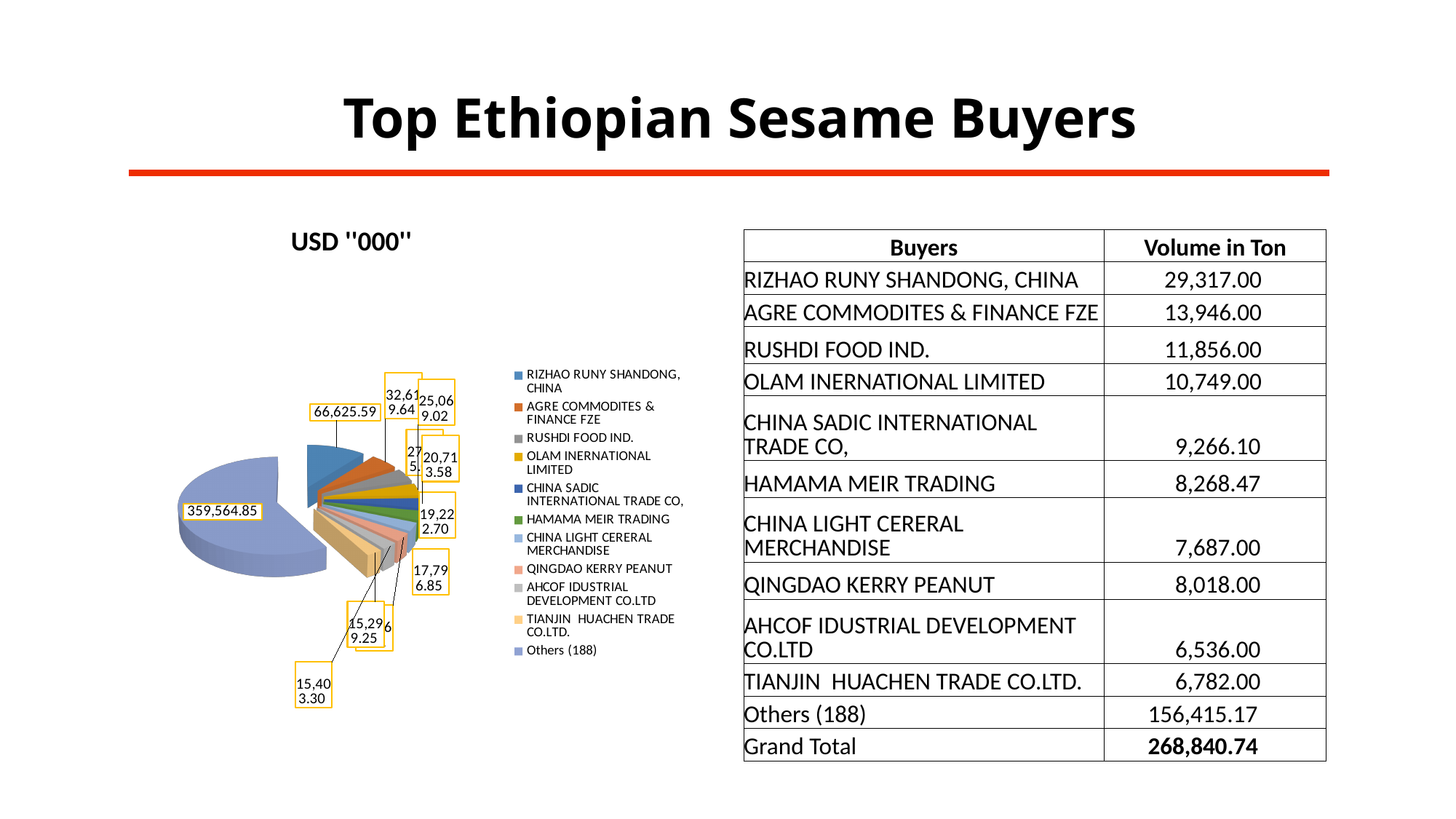
In the pie chart, which is larger: the Others (188) slice or the RIZHAO RUNY SHANDONG, CHINA slice? Others (188) What is the title of the pie chart? USD ''000'' How many entries does the legend of the pie chart list? 11 Which entry is listed last in the pie chart's legend? Others (188) What value is labelled on the RIZHAO RUNY SHANDONG, CHINA slice of the pie chart? 66,625.59 What is the difference between the Others (188) value and the RIZHAO RUNY SHANDONG, CHINA value in the pie chart? 292,939.26 What value is labelled on the Others (188) slice of the pie chart? 359,564.85 Which category has the largest slice in the pie chart? Others (188) What kind of chart is shown on the left of the slide? pie chart